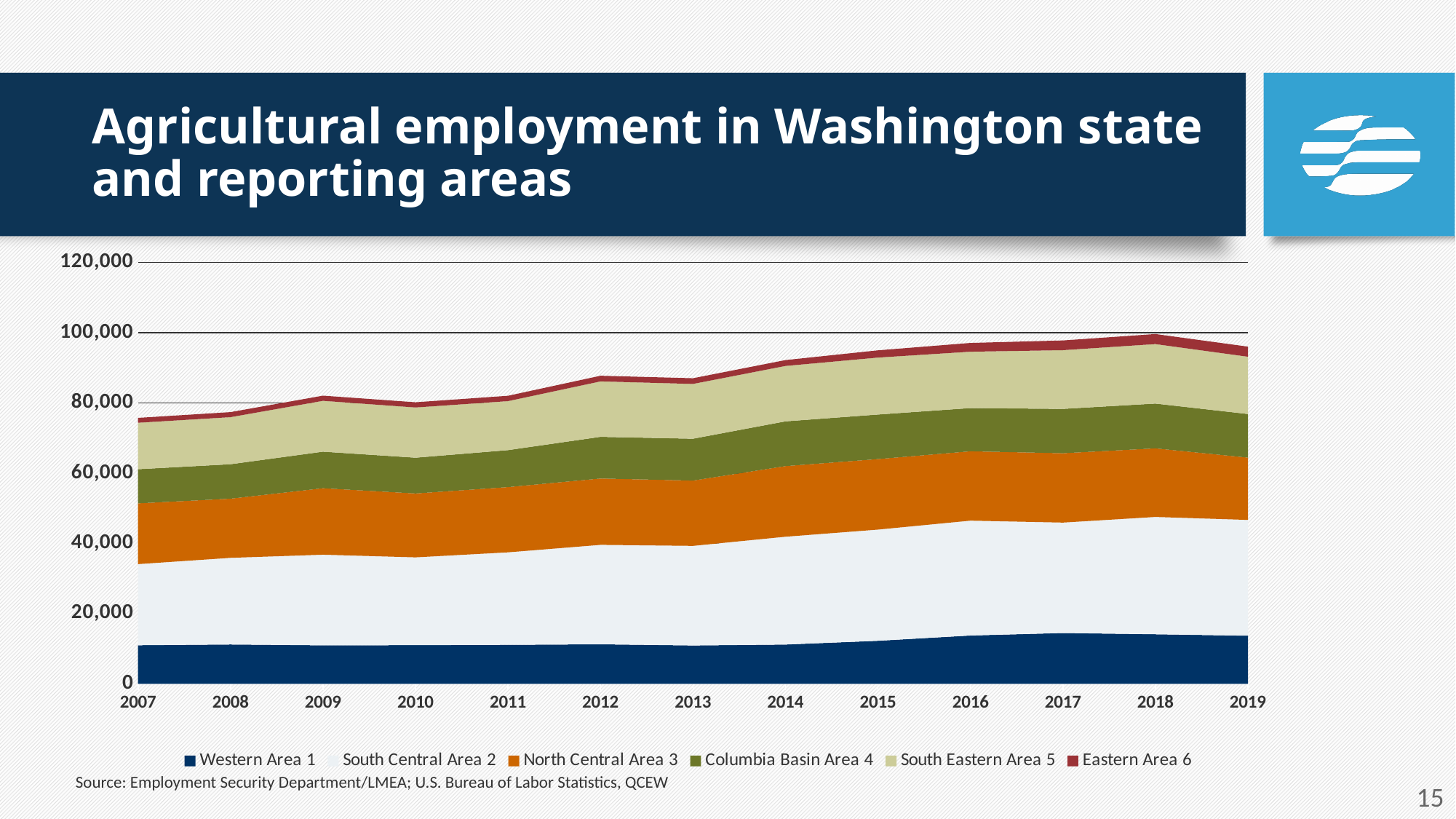
Is the value for Western Area 1 in 2007 greater or less than 20,000? less Does total agricultural employment generally rise or fall from 2007 to 2019? rise Which is larger, total agricultural employment in 2019 or in 2007? 2019 Is the total agricultural employment in 2007 greater or less than 80,000? less How many years are shown along the x axis? 13 What kind of chart is shown on the slide? Stacked area chart How many series does the legend list? 6 In which year is total agricultural employment lowest? 2007 What is the first year shown on the x axis? 2007 What is the last year shown on the x axis? 2019 Is the total agricultural employment in 2013 greater or less than 80,000? greater